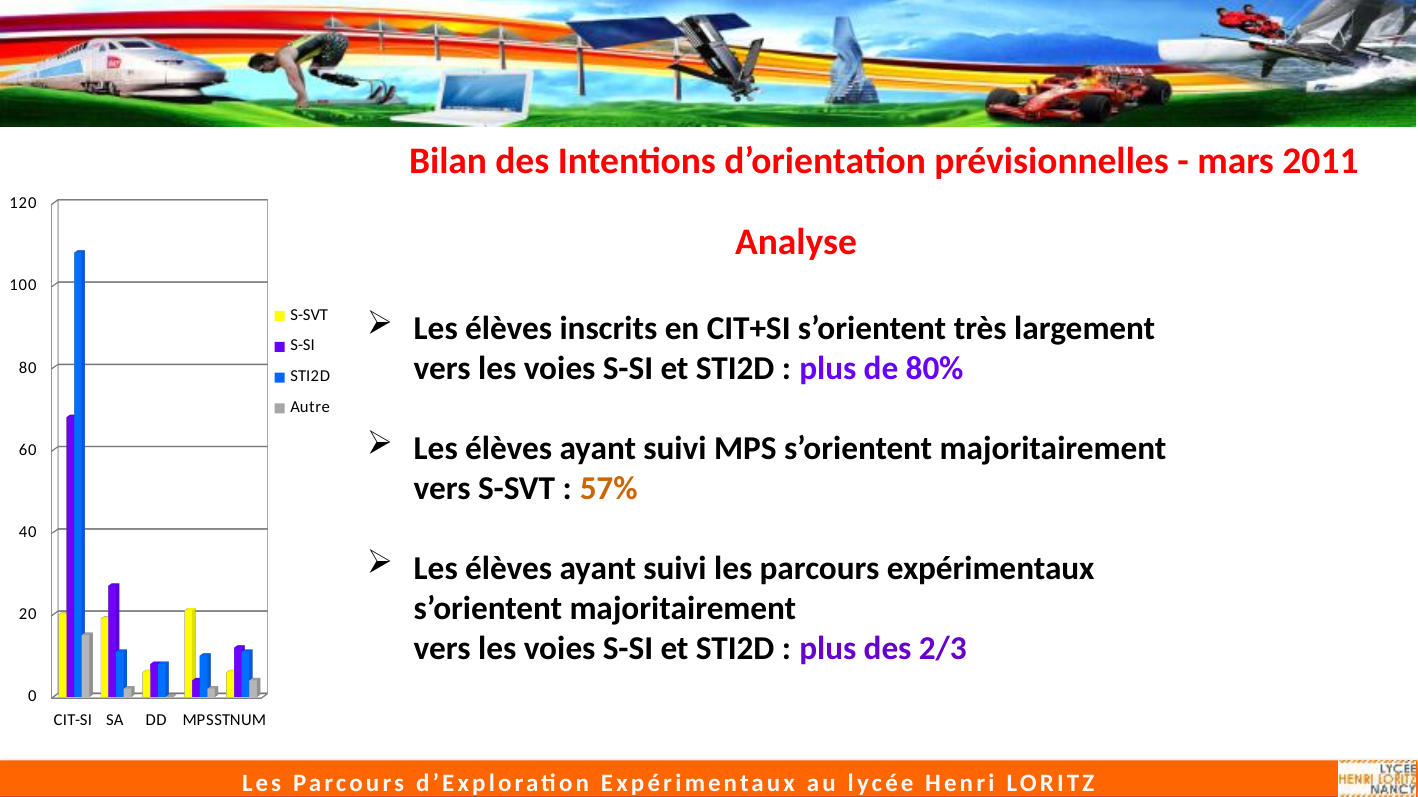
Which category has the tallest STI2D bar? CIT-SI Which series has the tallest bar in the MPS category? S-SVT For the CIT-SI category, which is larger: the STI2D bar or the S-SI bar? STI2D Is the S-SVT value for MPS greater or less than 40? less Is the S-SI value for SA greater or less than 20? greater How many series does the chart legend list? 4 Which colour represents the STI2D series in the legend? blue What kind of chart is shown on the slide? bar chart Is the S-SI value for CIT-SI greater or less than 60? greater How many categories are shown along the x axis of the chart? 5 For the SA category, which is larger: the S-SI bar or the S-SVT bar? S-SI